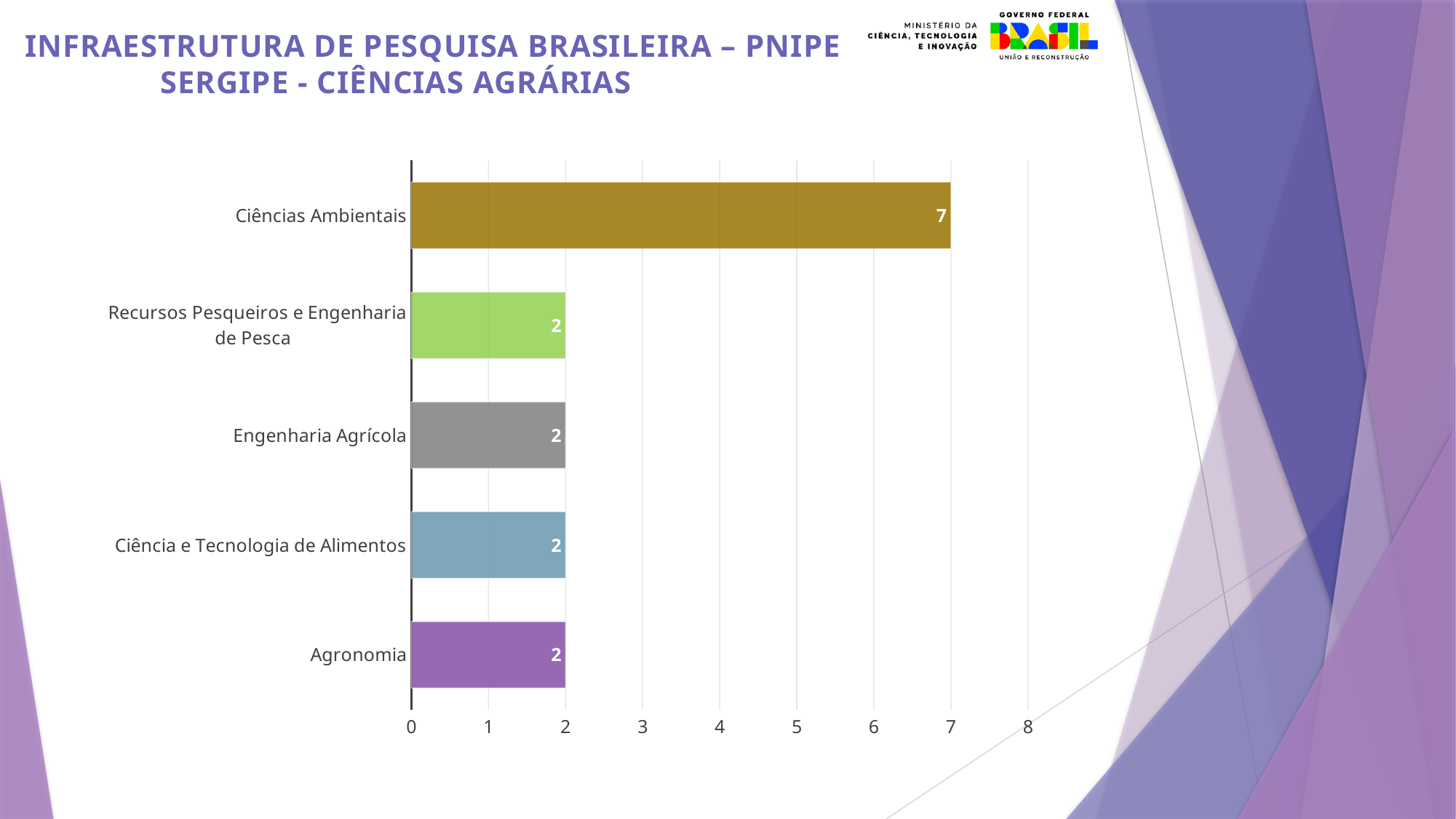
Which category has the highest value? Ciências Ambientais What is the value for Engenharia Agrícola? 2 Is the value for Ciências Ambientais greater or less than 5? greater What is the value for Recursos Pesqueiros e Engenharia de Pesca? 2 What is the value for Ciências Ambientais? 7 Which is larger, the value for Ciências Ambientais or the value for Agronomia? Ciências Ambientais What kind of chart is shown on the slide? Bar chart What is the value for Agronomia? 2 What is the highest value shown on the horizontal axis? 8 How many categories are shown in the chart? 5 What is the difference between the values for Ciências Ambientais and Ciência e Tecnologia de Alimentos? 5 How many categories have a value of 2? 4